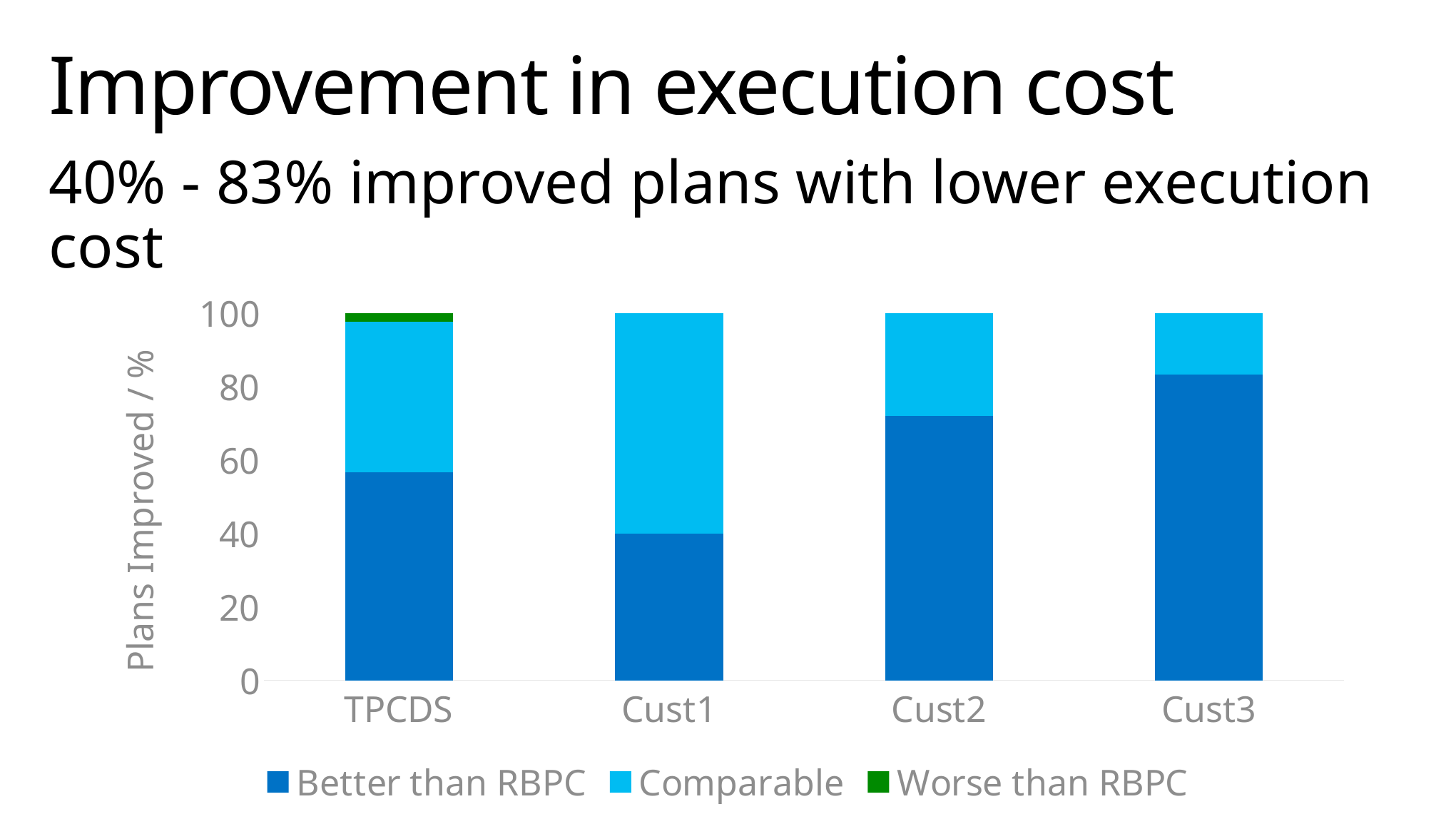
How many categories are shown on the x axis of the chart? 4 Which category has the highest value for Better than RBPC? Cust3 Which category has the largest Comparable segment? Cust1 Which category is the only one with a Worse than RBPC segment? TPCDS What kind of chart is shown on the slide? Stacked bar chart Which category has the lowest value for Better than RBPC? Cust1 Which is larger, the Better than RBPC value for Cust2 or for TPCDS? Cust2 Which category has the smallest Comparable segment? Cust3 How many series does the chart legend list? 3 Is the Better than RBPC value for TPCDS greater or less than 40? greater Is the Better than RBPC value for Cust1 greater or less than 60? less Is the Better than RBPC value for Cust2 greater or less than 60? greater